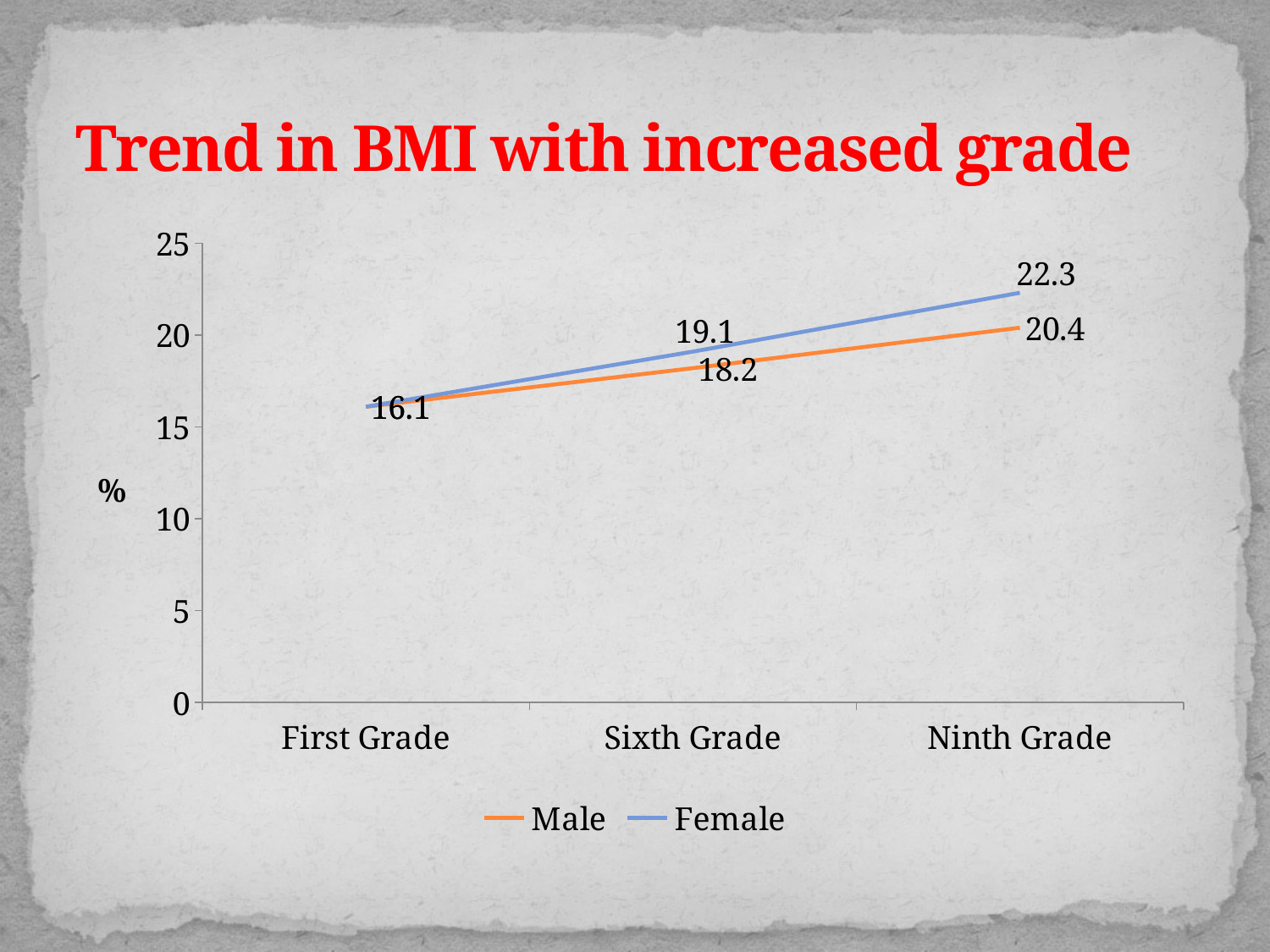
What is the Female value at Ninth Grade? 22.3 At which grade does the Female series reach its highest value? Ninth Grade What is the difference between the Female and Male values at Sixth Grade? 0.9 How many series does the legend list? 2 What is the Female value at Sixth Grade? 19.1 What is the difference between the Female and Male values at Ninth Grade? 1.9 At Sixth Grade, which series has the larger value, Male or Female? Female What is the Male value at Sixth Grade? 18.2 What kind of chart is shown on the slide? line chart How many grade categories are shown on the x axis? 3 Do the Male values rise or fall from First Grade to Ninth Grade? rise What is the Male value at Ninth Grade? 20.4